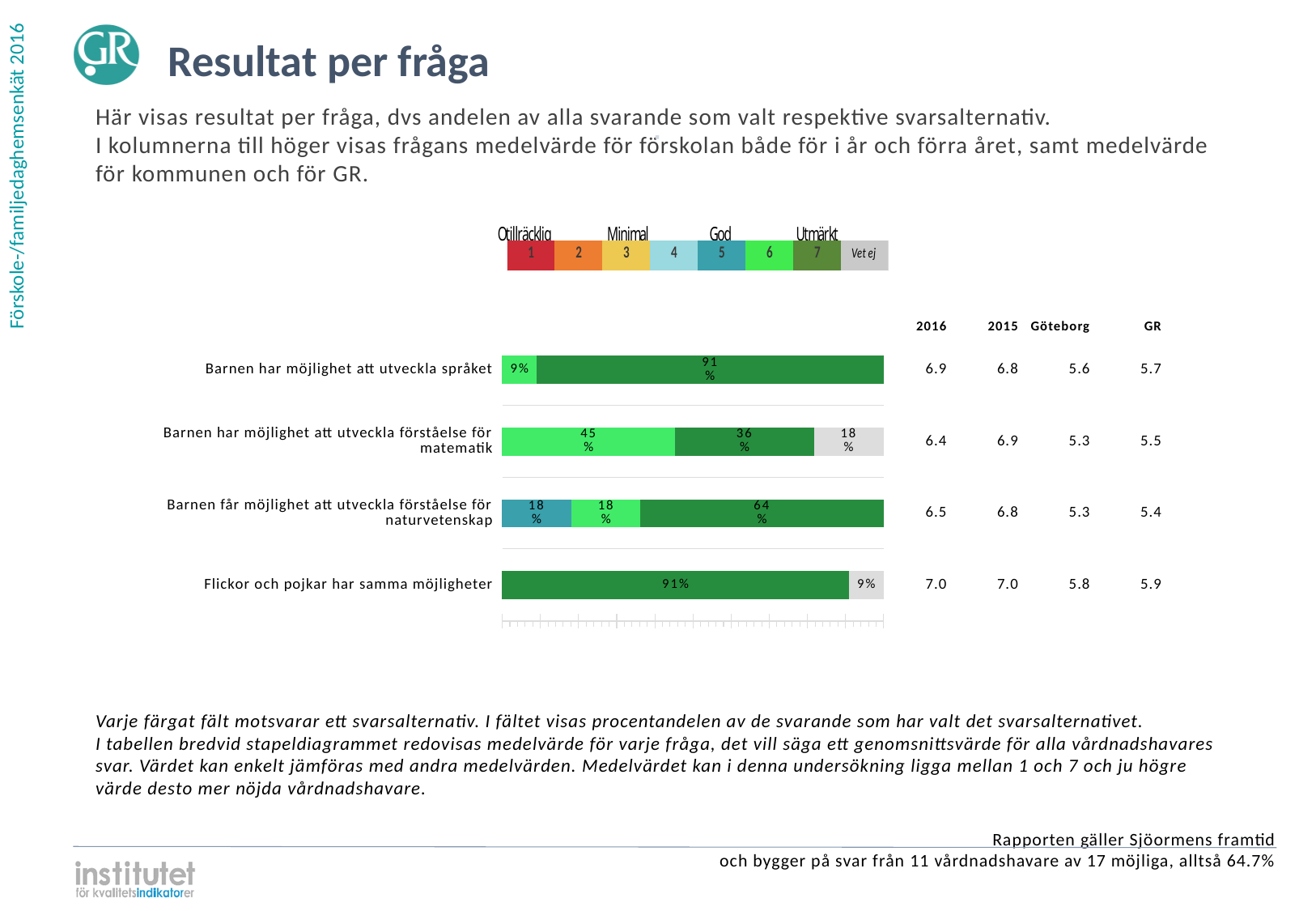
What percentage chose answer 6 (light green) for "Barnen har möjlighet att utveckla förståelse för matematik"? 45% Is the answer-7 share for "Barnen har möjlighet att utveckla förståelse för matematik" larger or smaller than its answer-6 share? smaller What percentage chose answer 7 (dark green) for "Barnen får möjlighet att utveckla förståelse för naturvetenskap"? 64% How many questions (categories) are plotted in the bar chart? 4 What kind of chart is shown on the slide? bar chart What is the 2016 mean value shown for "Flickor och pojkar har samma möjligheter"? 7.0 What is the difference between the answer-7 share for "Barnen har möjlighet att utveckla språket" (91%) and for "Barnen får möjlighet att utveckla förståelse för naturvetenskap" (64%)? 27 percentage points What percentage of respondents chose answer 7 (dark green) for "Barnen har möjlighet att utveckla språket"? 91% What percentage answered "Vet ej" for "Barnen har möjlighet att utveckla förståelse för matematik"? 18% Which question has the largest share of answer 7 (dark green)? Barnen har möjlighet att utveckla språket and Flickor och pojkar har samma möjligheter (both 91%) What percentage answered "Vet ej" for "Flickor och pojkar har samma möjligheter"? 9% How many answer options does the legend above the chart list, including "Vet ej"? 8